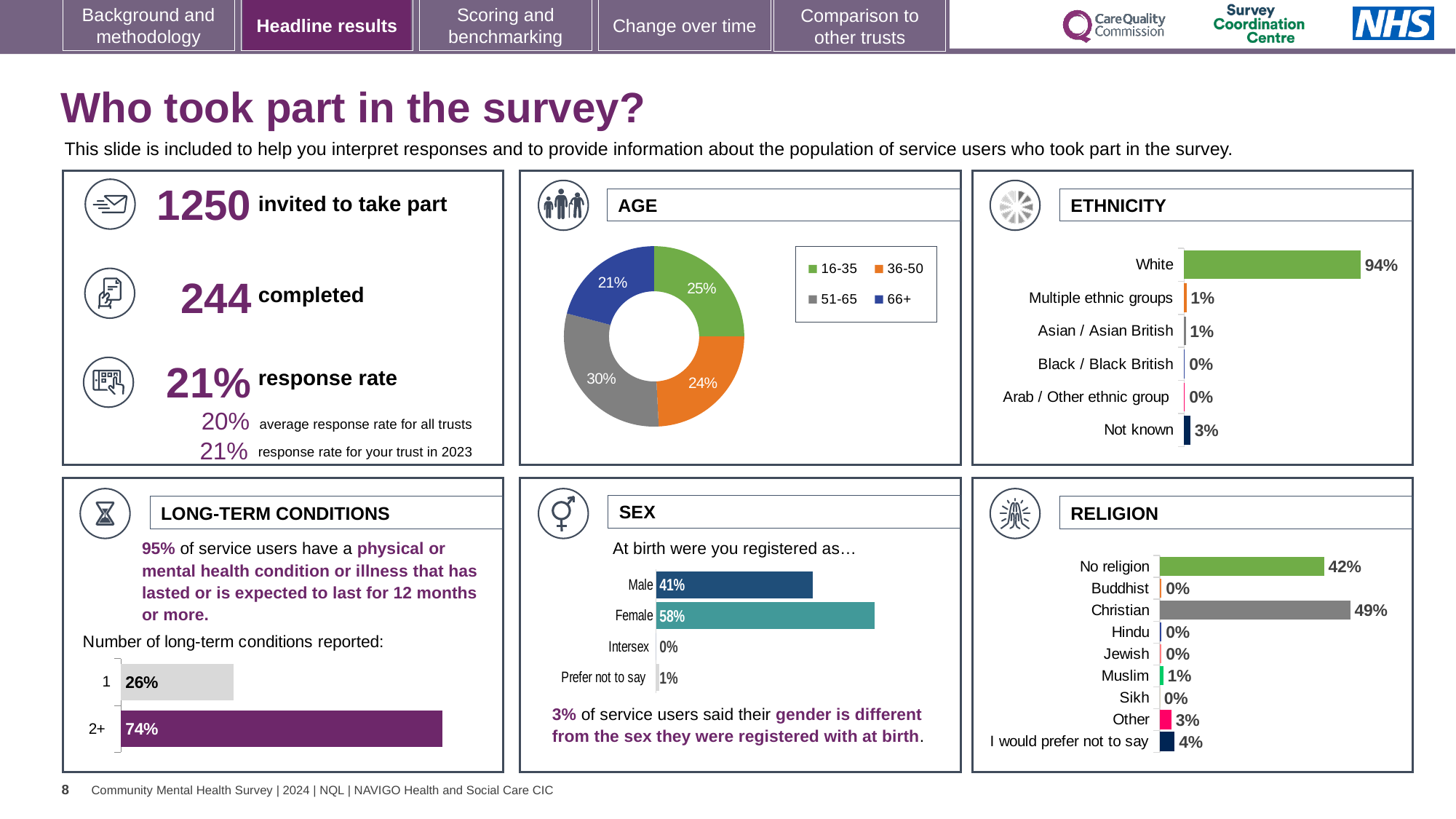
In the RELIGION chart, which category has the highest value? Christian In the AGE chart, what share of respondents are aged 51-65? 30% In the AGE chart, which age group has the smallest share? 66+ In the SEX chart, which is larger, Male or Female? Female In the ETHNICITY chart, what is the value for White? 94% What kind of chart is the AGE chart? Doughnut chart How many series does the legend of the AGE chart list? 4 In the RELIGION chart, what is the value for I would prefer not to say? 4% In the SEX chart, what is the difference between the Female and Male values? 17% In the ETHNICITY chart, what is the value for Not known? 3% In the LONG-TERM CONDITIONS chart, what share of service users reported 2+ conditions? 74% How many categories are shown in the ETHNICITY chart? 6